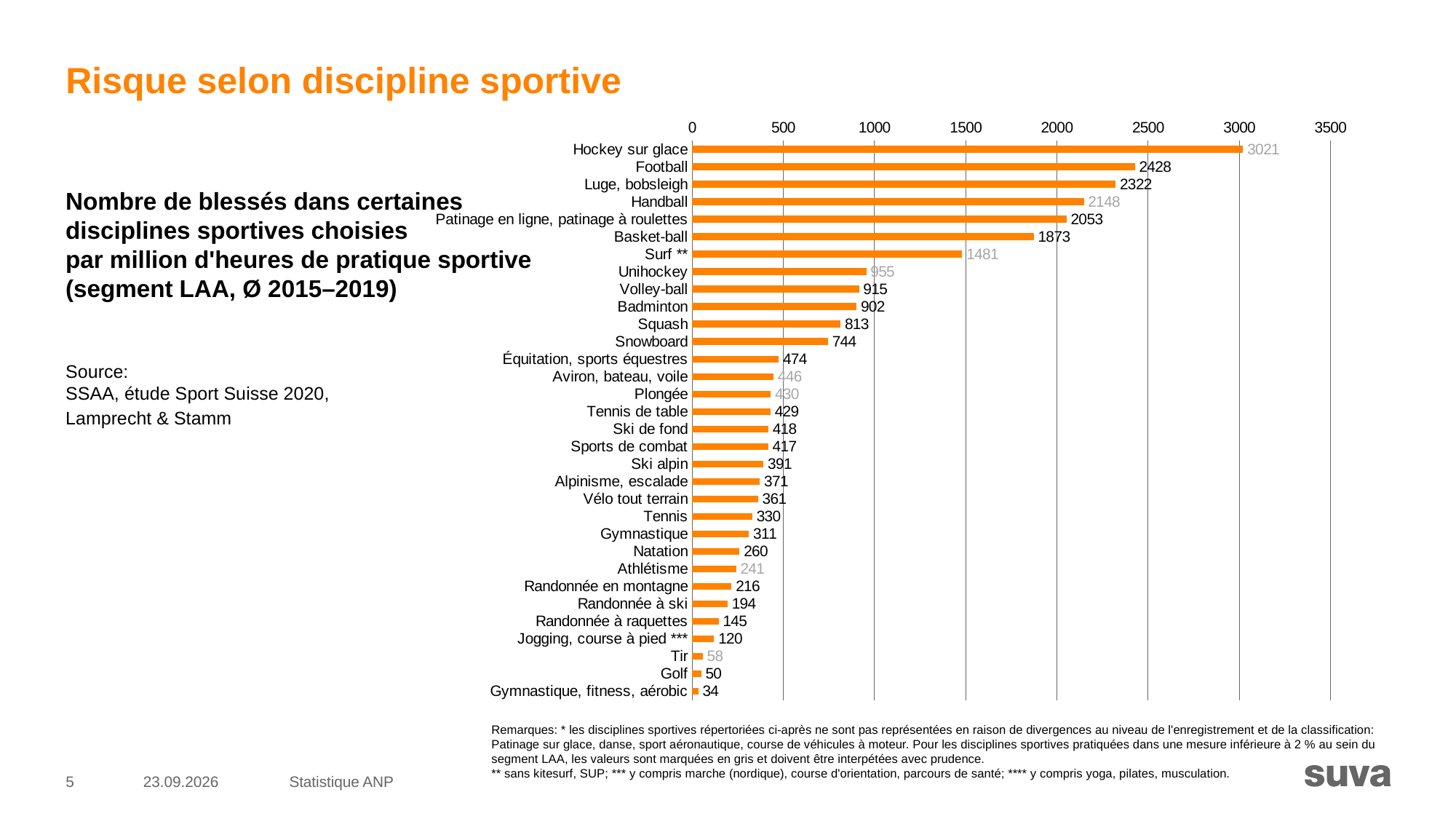
What is the value for Hockey sur glace? 3021 What is the difference between the values for Football and Luge, bobsleigh? 106 What kind of chart is shown on the slide? bar chart How many disciplines are shown in the chart? 32 Which discipline has the highest value? Hockey sur glace What is the value for Golf? 50 What is the value for Snowboard? 744 Is the value for Surf ** greater or less than 1500? less What is the value for Basket-ball? 1873 What is the title of the slide? Risque selon discipline sportive Which has a larger value, Squash or Tennis? Squash Which discipline has the lowest value? Gymnastique, fitness, aérobic